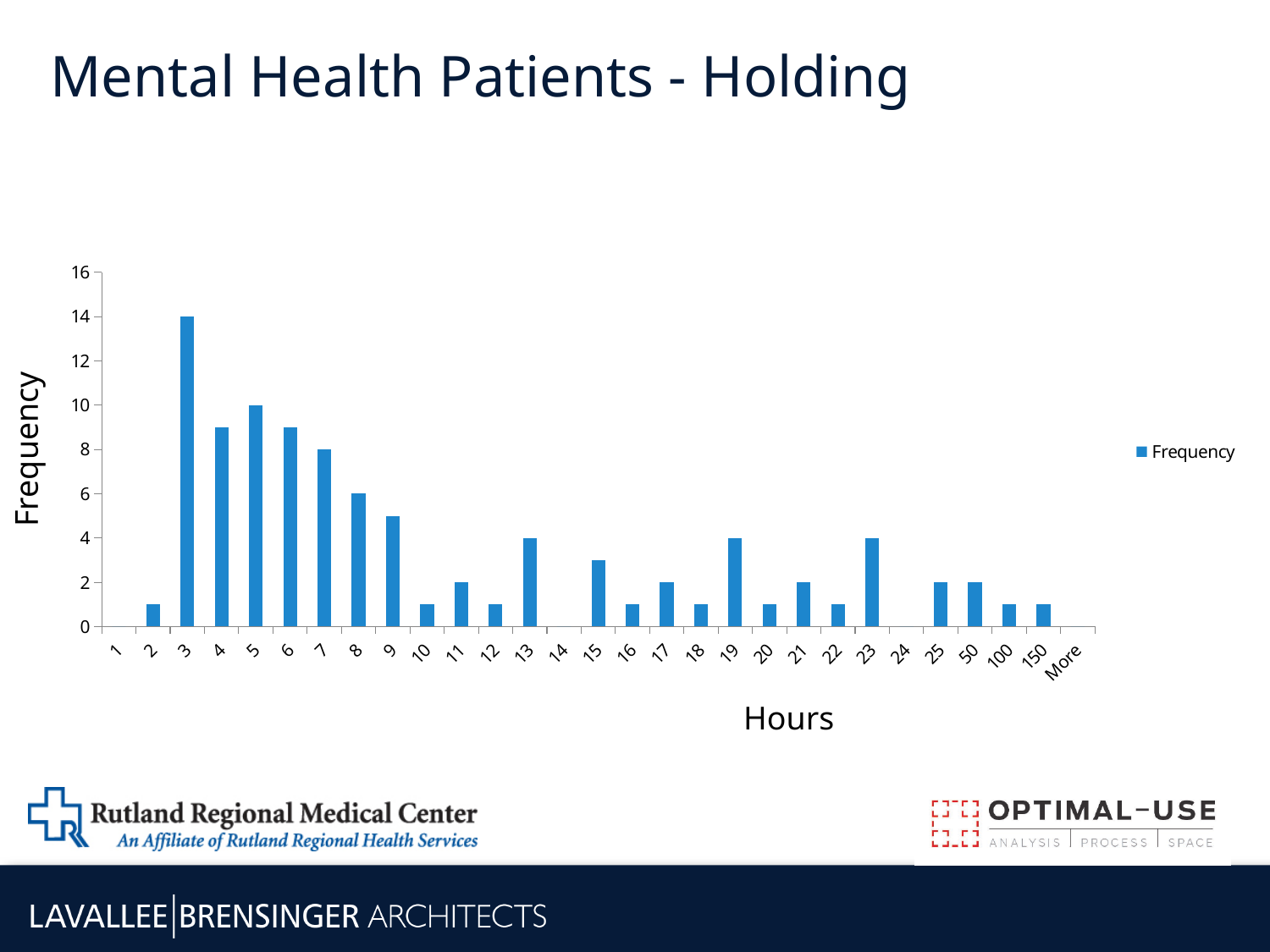
What is the frequency for the 8-hour category? 6 What is the frequency for the 7-hour category? 8 Which is larger, the frequency for 9 hours or the frequency for 13 hours? 9 hours How many series does the legend list? 1 What type of chart is shown on the slide? bar chart Is the frequency for the 15-hour category greater or less than 4? less Is the frequency for the 4-hour category greater or less than 8? greater What is the frequency for the 3-hour category? 14 What is the frequency for the 13-hour category? 4 What is the frequency for the 5-hour category? 10 Which hours category has the highest frequency? 3 What is the difference between the frequency for 3 hours and the frequency for 5 hours? 4